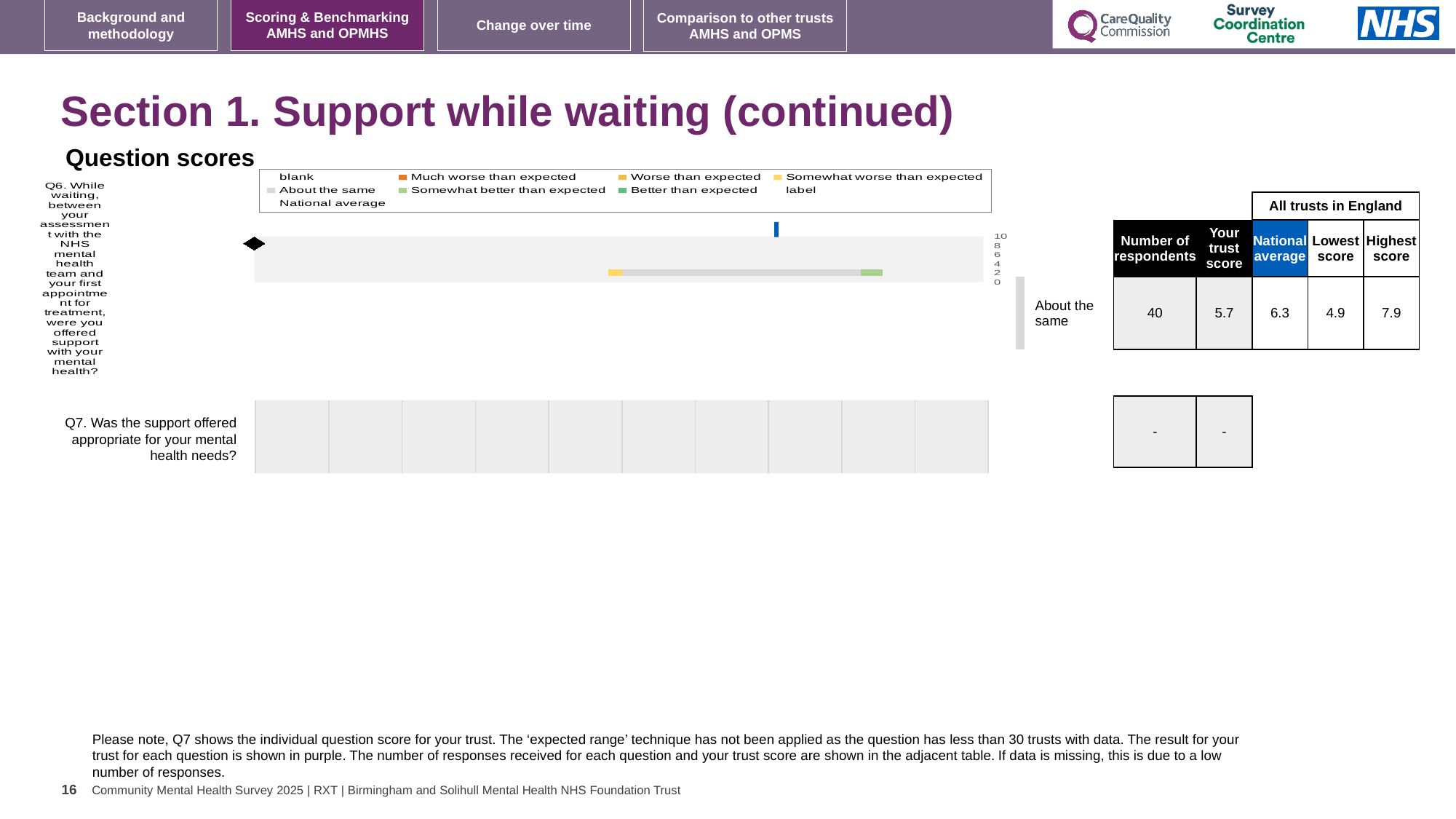
What kind of chart is used to show the Q6 question score? bar chart What is the national average score for Q6? 6.3 For Q6, which is larger: the trust score or the national average? national average What is the trust score for Q6 shown in the table next to the chart? 5.7 What is the lowest score among all trusts in England for Q6? 4.9 What is the difference between the highest score and the lowest score for Q6? 3.0 Which expected-range category is the Q6 trust result labelled as? About the same By how much does the national average exceed the trust score for Q6? 0.6 How many respondents answered Q6? 40 What is the highest score among all trusts in England for Q6? 7.9 Is the trust score for Q6 greater or less than 6? less What is shown for the Q7 trust score in the table? -